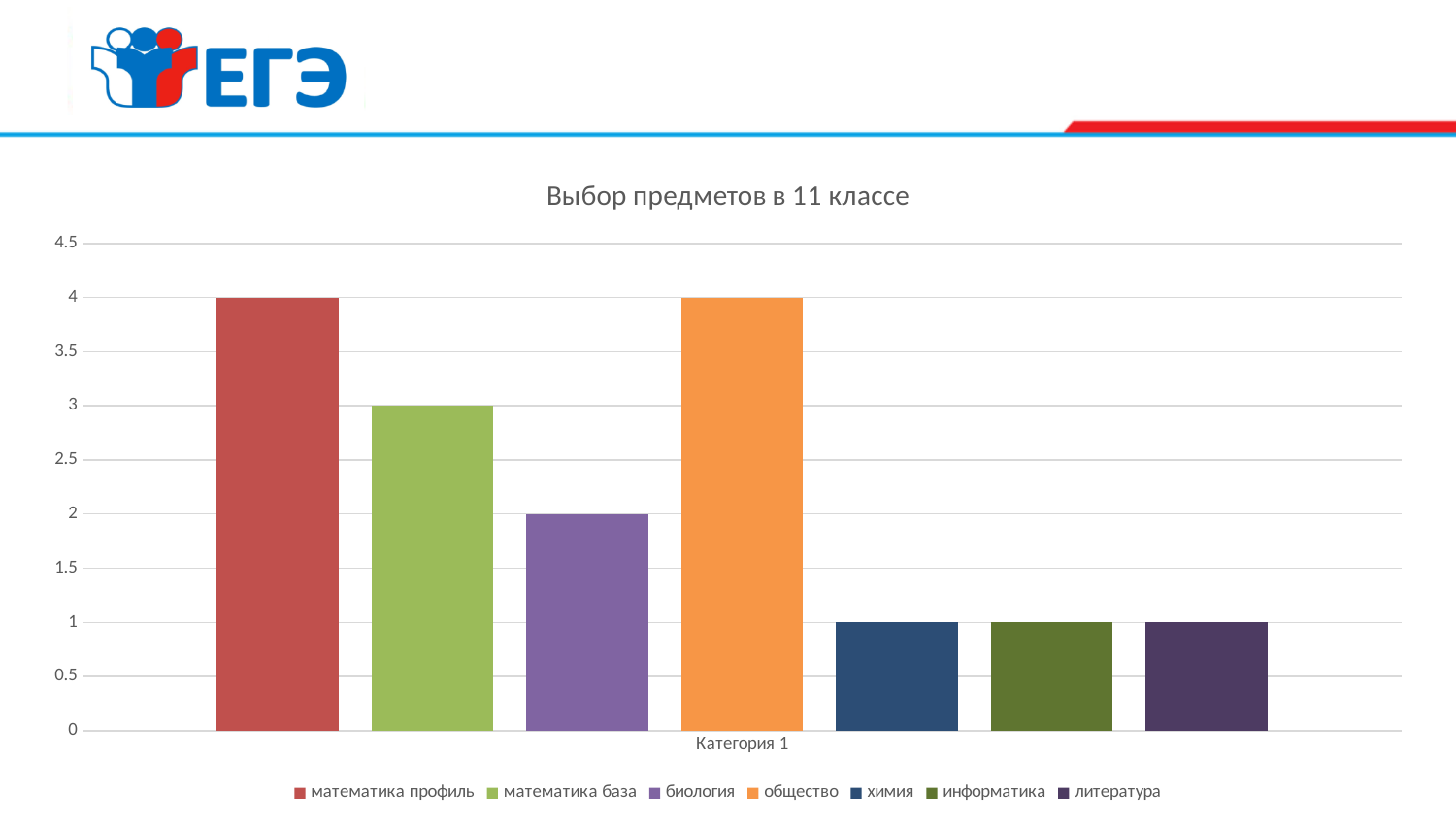
What is the value for общество? 4 How many series does the legend list? 7 What is the difference between the values for математика профиль and биология? 2 What type of chart is shown on the slide? bar chart What is the label of the category on the x axis? Категория 1 What is the value for математика профиль? 4 What is the title of the chart? Выбор предметов в 11 классе Which is larger, математика база or биология? математика база What is the value for биология? 2 What is the value for химия? 1 Is the value for информатика greater or less than 2? less What is the value for математика база? 3